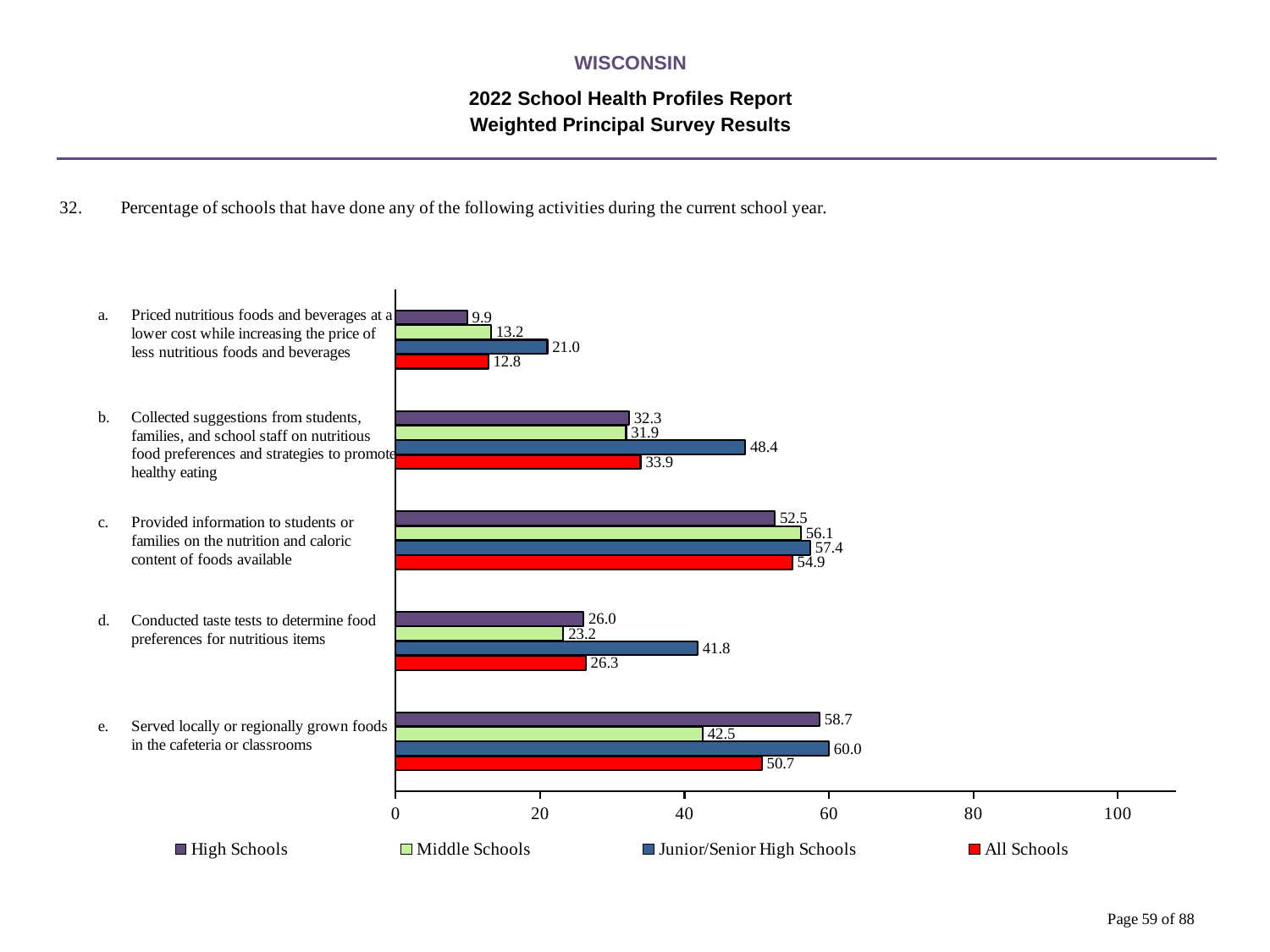
Which activity has the lowest value for All Schools? a. Priced nutritious foods and beverages at a lower cost while increasing the price of less nutritious foods and beverages Which colour represents All Schools in the legend? Red What is the value for Junior/Senior High Schools for activity b (collected suggestions from students, families, and school staff)? 48.4 How many activities (categories) are shown in the chart? 5 Which activity has the highest value for High Schools? e. Served locally or regionally grown foods in the cafeteria or classrooms What is the value for All Schools for activity e (served locally or regionally grown foods)? 50.7 Is the Junior/Senior High Schools value for activity c greater or less than 40? greater For activity e, which is larger: the Middle Schools value or the High Schools value? High Schools What is the difference between the Junior/Senior High Schools and High Schools values for activity d (conducted taste tests)? 15.8 How many series does the legend list? 4 What is the value for Middle Schools for activity a (priced nutritious foods at a lower cost)? 13.2 What kind of chart is shown on the slide? Bar chart